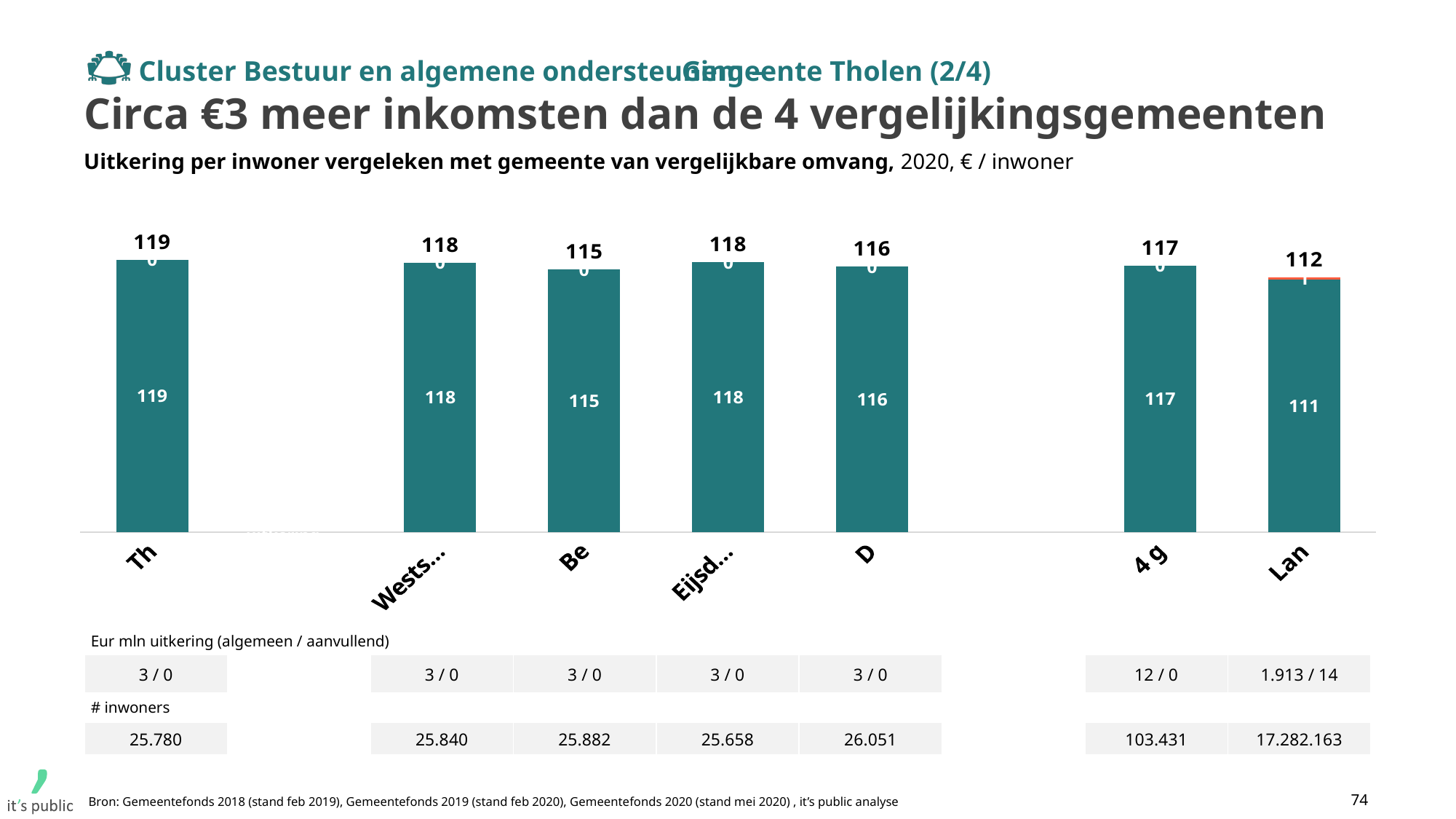
Which has a higher total, the bar labelled "Wests..." or the bar labelled "D"? Wests... How many bars are plotted in the chart? 7 What is the total value shown above the bar labelled "Be"? 115 What is the value of the large teal segment in the bar labelled "Lan"? 111 What unit is stated in the chart subtitle for the values plotted? € / inwoner What is the total value shown above the bar labelled "Th"? 119 What is the difference between the total for "Th" and the total for "Lan"? 7 Which bar has the highest total value? Th Which bar has the lowest total value? Lan What kind of chart is shown on the slide? Bar chart What is the total value shown above the bar labelled "Lan"? 112 What is the difference between the total for "Th" and the total for "Be"? 4